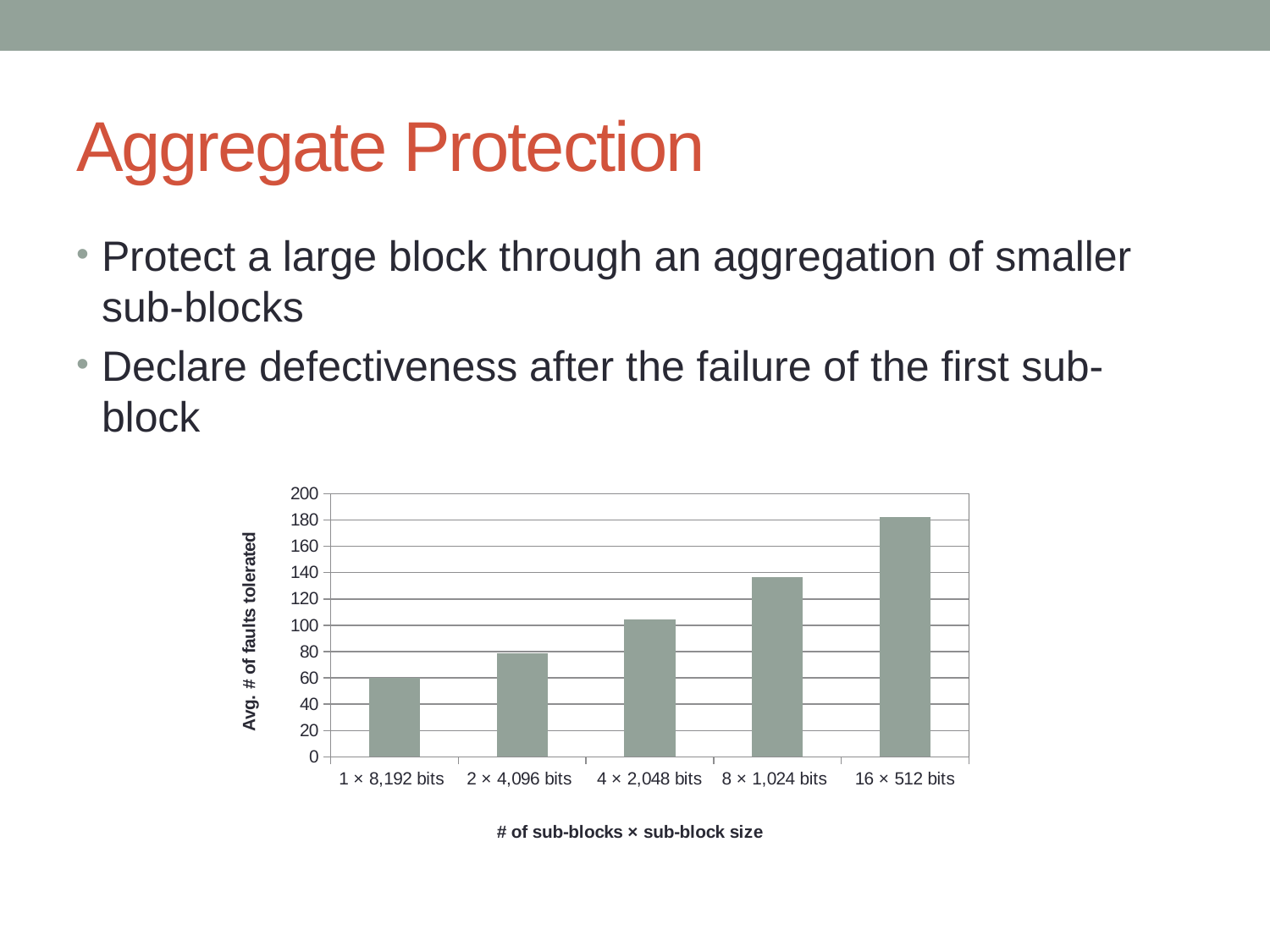
How many categories are shown on the x axis of the chart? 5 What kind of chart is shown on the slide? bar chart Is the value for 4 × 2,048 bits greater or less than 120? less Is the value for 16 × 512 bits greater or less than 160? greater What is the label of the y axis of the chart? Avg. # of faults tolerated Is the value for 2 × 4,096 bits greater or less than 100? less What is the label of the x axis of the chart? # of sub-blocks × sub-block size Which category has the lowest average number of faults tolerated? 1 × 8,192 bits Which category has the highest average number of faults tolerated? 16 × 512 bits Do the values rise or fall as the number of sub-blocks increases along the x axis? rise Which is larger, the value for 4 × 2,048 bits or the value for 2 × 4,096 bits? 4 × 2,048 bits